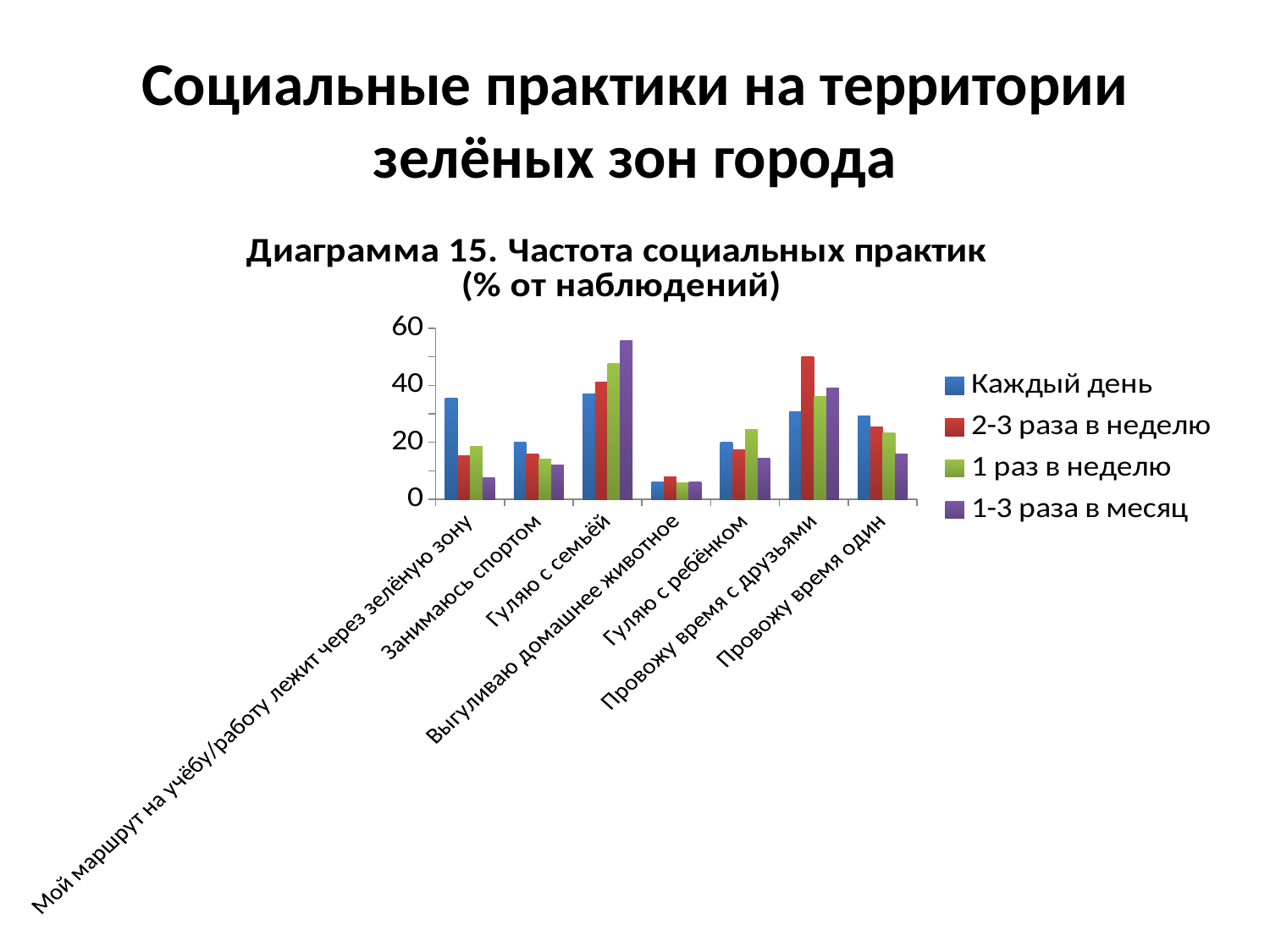
What kind of chart is shown on the slide? Bar chart What is the title of the chart? Диаграмма 15. Частота социальных практик (% от наблюдений) In the category "Провожу время с друзьями", which series has the larger value: "Каждый день" or "2-3 раза в неделю"? 2-3 раза в неделю How many series does the legend of the chart list? 4 Which category has the lowest value for the series "Каждый день"? Выгуливаю домашнее животное How many categories are shown on the x axis of the chart? 7 What colour represents the series "Каждый день" in the chart? Blue Is the value for "Каждый день" in the category "Мой маршрут на учёбу/работу лежит через зелёную зону" greater or less than 20? greater Which category has the highest value for the series "2-3 раза в неделю"? Провожу время с друзьями Is the value for "1-3 раза в месяц" in the category "Гуляю с семьёй" greater or less than 40? greater Which category has the highest value for the series "1-3 раза в месяц"? Гуляю с семьёй Is the value for "2-3 раза в неделю" in the category "Выгуливаю домашнее животное" greater or less than 20? less